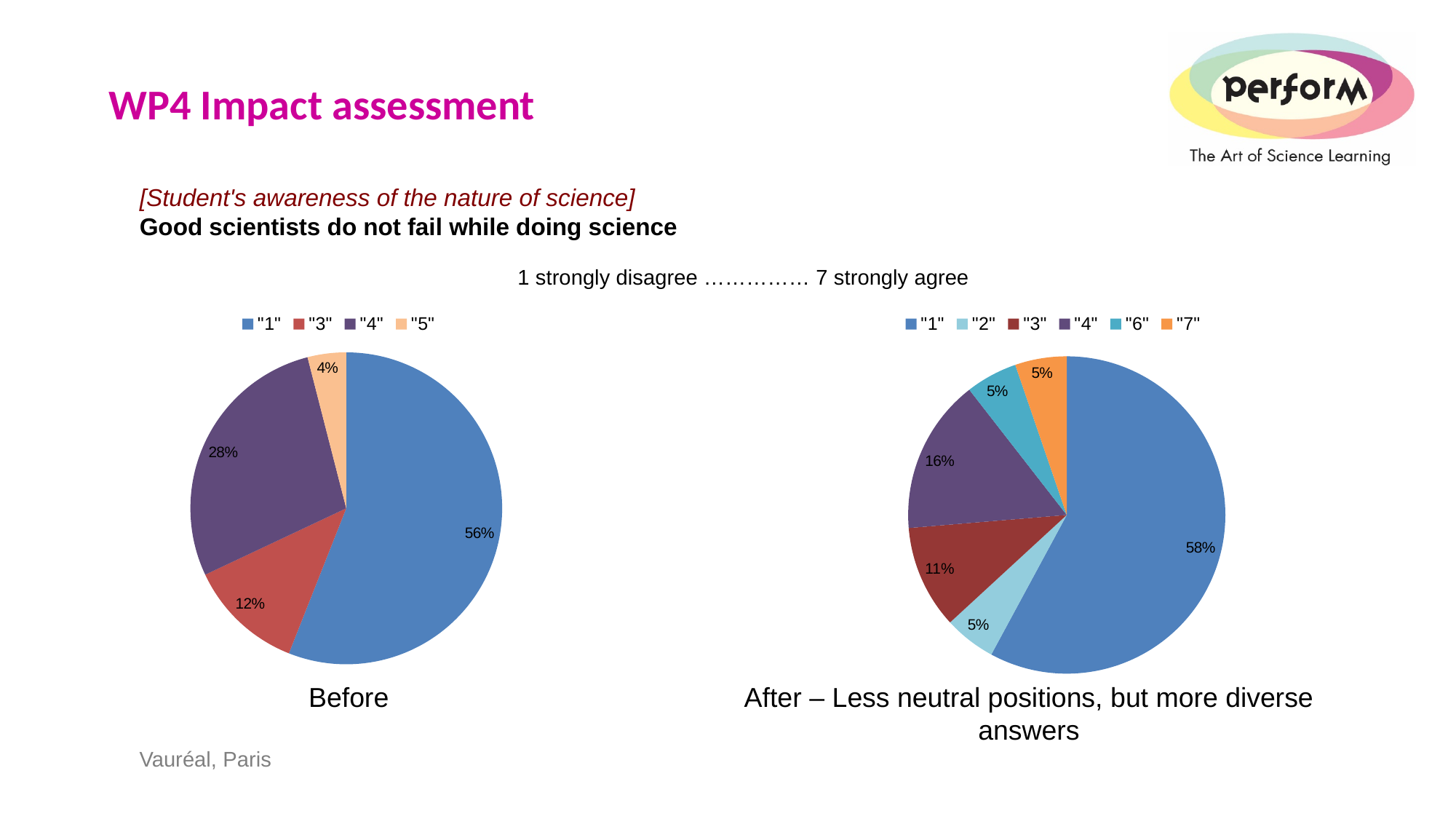
What type of chart is used for the Before and After data? Pie chart In the After pie chart, what is the combined share of ratings "6" and "7"? 10% In the After pie chart, which is larger: the share for rating "3" or the share for rating "4"? "4" In the After pie chart, which rating has the largest slice? "1" In the Before pie chart, what is the difference between the shares for rating "4" and rating "3"? 16% In the After pie chart, what share of responses is rating "1"? 58% In the Before pie chart, what share of responses is rating "1"? 56% In the Before pie chart, what share of responses is rating "4"? 28% In the Before pie chart, which rating has the smallest slice? "5" In the After pie chart, what share of responses is rating "4"? 16% How many entries does the legend of the Before pie chart list? 4 How many slices does the After pie chart have? 6